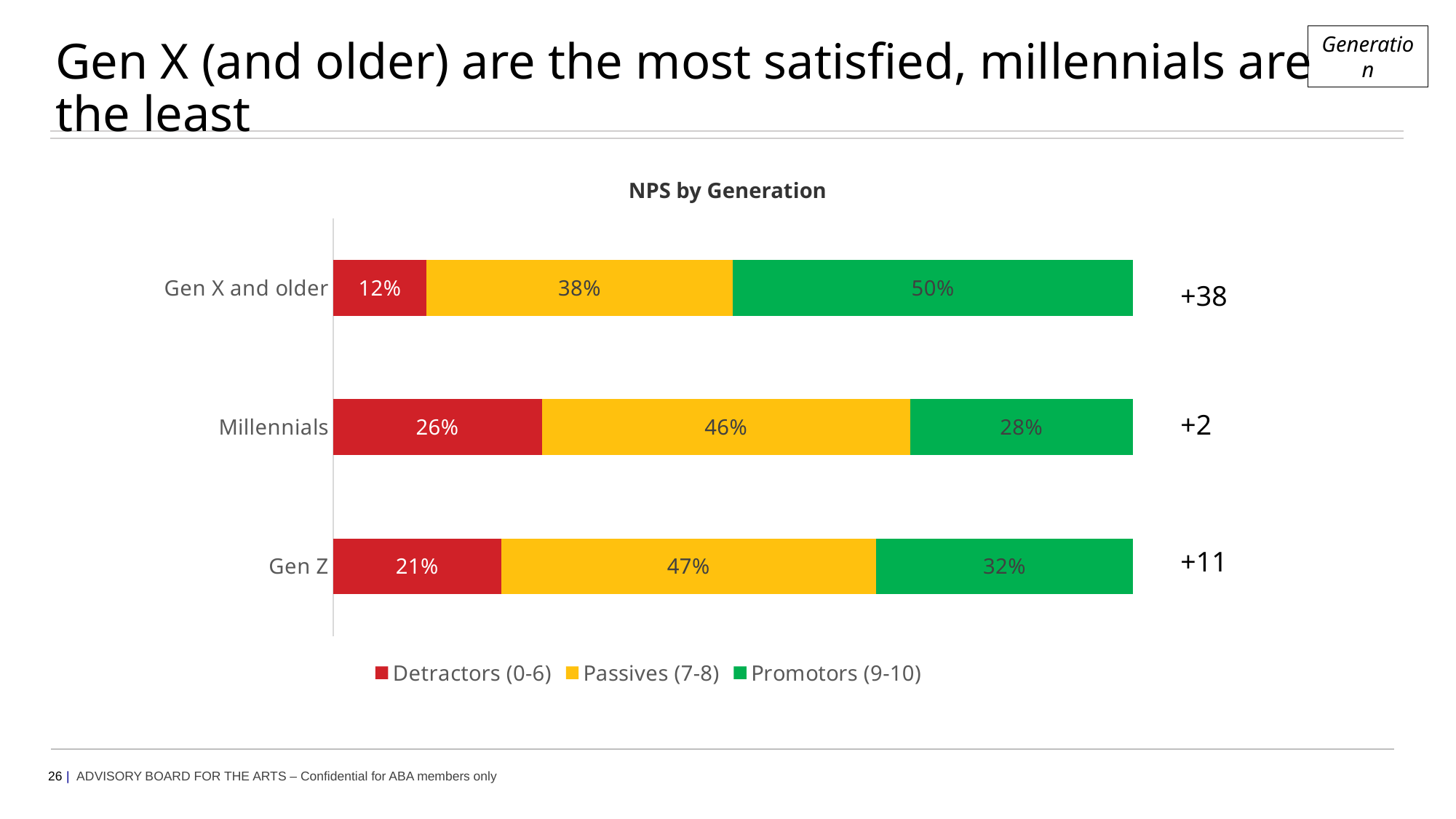
Which generation has the highest share of Promotors (9-10)? Gen X and older What is the difference between the Passives (7-8) share for Gen Z and for Gen X and older? 9% What is the title of the chart? NPS by Generation How many series does the legend list? 3 What percentage of Gen X and older are Promotors (9-10)? 50% Which generation has the lowest share of Detractors (0-6)? Gen X and older What percentage of Millennials are Detractors (0-6)? 26% What kind of chart is shown on the slide? Stacked bar chart Which is larger: the Promotors (9-10) share for Millennials or for Gen Z? Gen Z What percentage of Gen Z are Passives (7-8)? 47% How many generations are shown in the chart? 3 What NPS score is shown next to the Millennials bar? +2